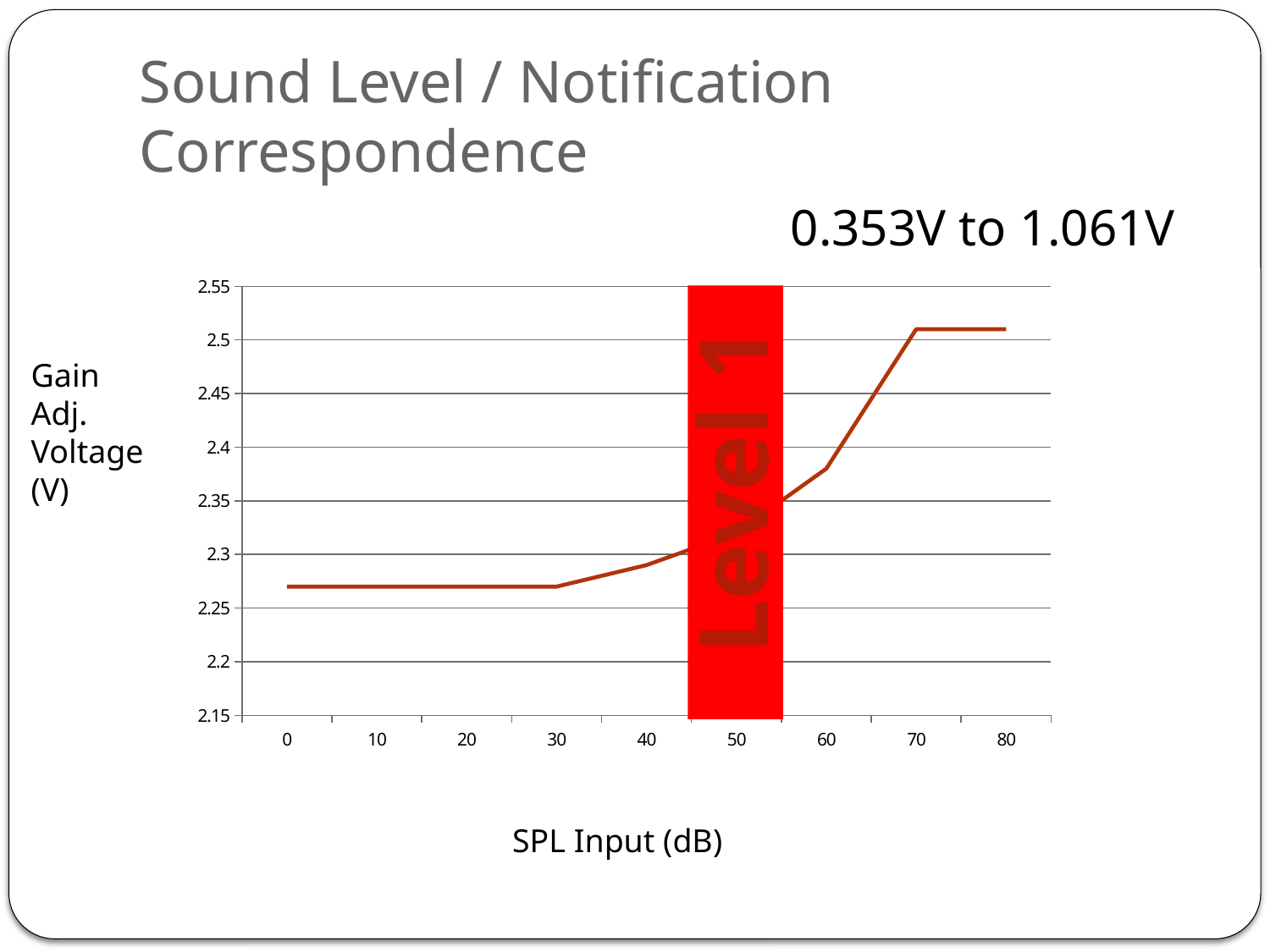
How many SPL Input values are marked along the x axis of the chart? 9 Which has the higher Gain Adj. Voltage: an SPL Input of 30 dB or 60 dB? 60 dB Is the Gain Adj. Voltage at an SPL Input of 30 dB greater or less than 2.3? less What kind of chart is shown on the slide? line chart What label is written on the red shaded band in the chart? Level 1 Which has the higher Gain Adj. Voltage: an SPL Input of 40 dB or 80 dB? 80 dB Is the Gain Adj. Voltage at an SPL Input of 80 dB greater or less than 2.45? greater Is the Gain Adj. Voltage at an SPL Input of 40 dB greater or less than 2.35? less What is the title of the x axis of the chart? SPL Input (dB) Does the Gain Adj. Voltage generally rise or fall as SPL Input increases from 0 to 80 dB? rise